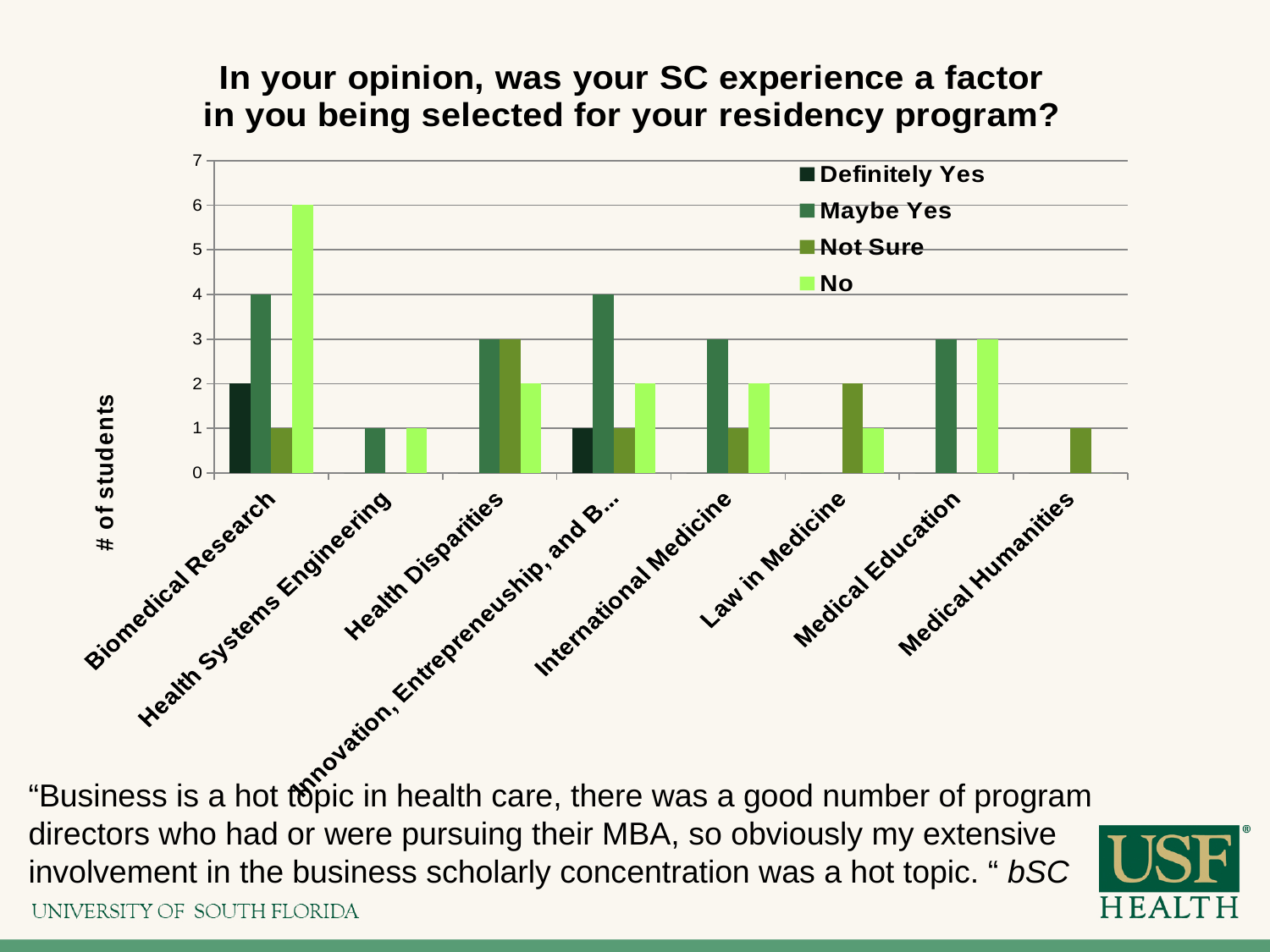
What is the difference between the "No" and "Maybe Yes" counts for Biomedical Research? 2 Which has more "Maybe Yes" responses: Innovation, Entrepreneurship, and B... or International Medicine? Innovation, Entrepreneurship, and B... How many students in Biomedical Research answered "No"? 6 What is the label on the vertical axis? # of students How many students in Biomedical Research answered "Maybe Yes"? 4 How many series does the legend list? 4 How many students in Law in Medicine answered "Not Sure"? 2 Is the "No" value for Biomedical Research greater or less than 5? greater How many students in Medical Humanities answered "Not Sure"? 1 How many scholarly concentration categories are shown on the x axis? 8 What kind of chart is shown on the slide? bar chart Which category has the tallest bar in the chart? Biomedical Research